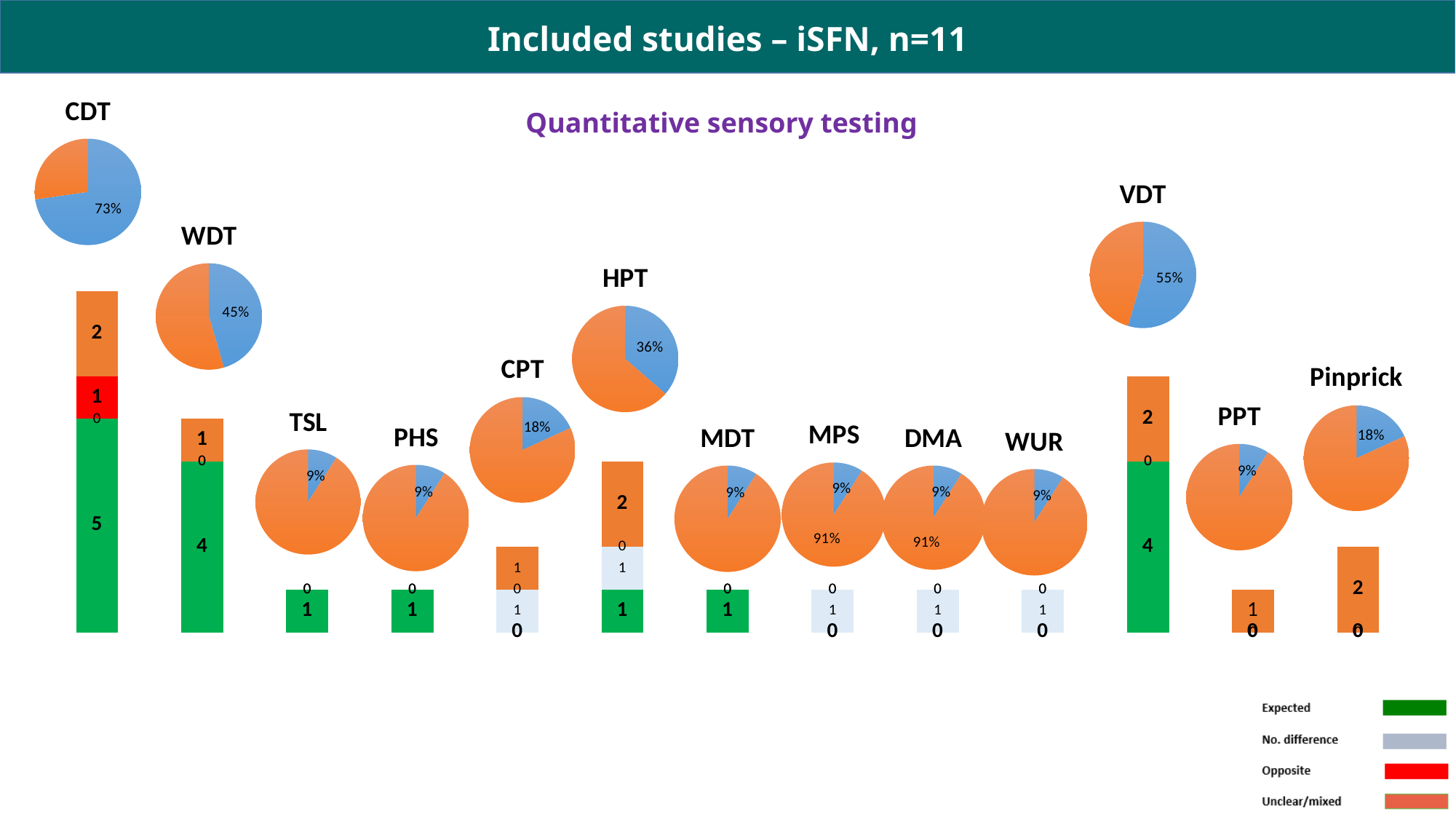
Is the blue slice larger in the CDT pie chart or the WDT pie chart? CDT How many entries does the legend at the bottom right of the slide list? 4 In the Pinprick stacked bar, what is the value of the orange (Unclear/mixed) segment? 2 In the MPS pie chart, what percentage is shown for the orange slice? 91% In the VDT pie chart, what percentage is shown for the blue slice? 55% In the HPT pie chart, what percentage is shown for the blue slice? 36% Which pie chart on the slide has the largest blue slice? CDT What is the difference between the blue slice percentages in the CDT and VDT pie charts? 18 percentage points What is the total of the VDT stacked bar (2, 0 and 4)? 6 In the CDT stacked bar, what is the value of the red (Opposite) segment? 1 In the CDT stacked bar, what is the value of the green (Expected) segment? 5 In the CDT pie chart, what percentage is shown for the blue slice? 73%